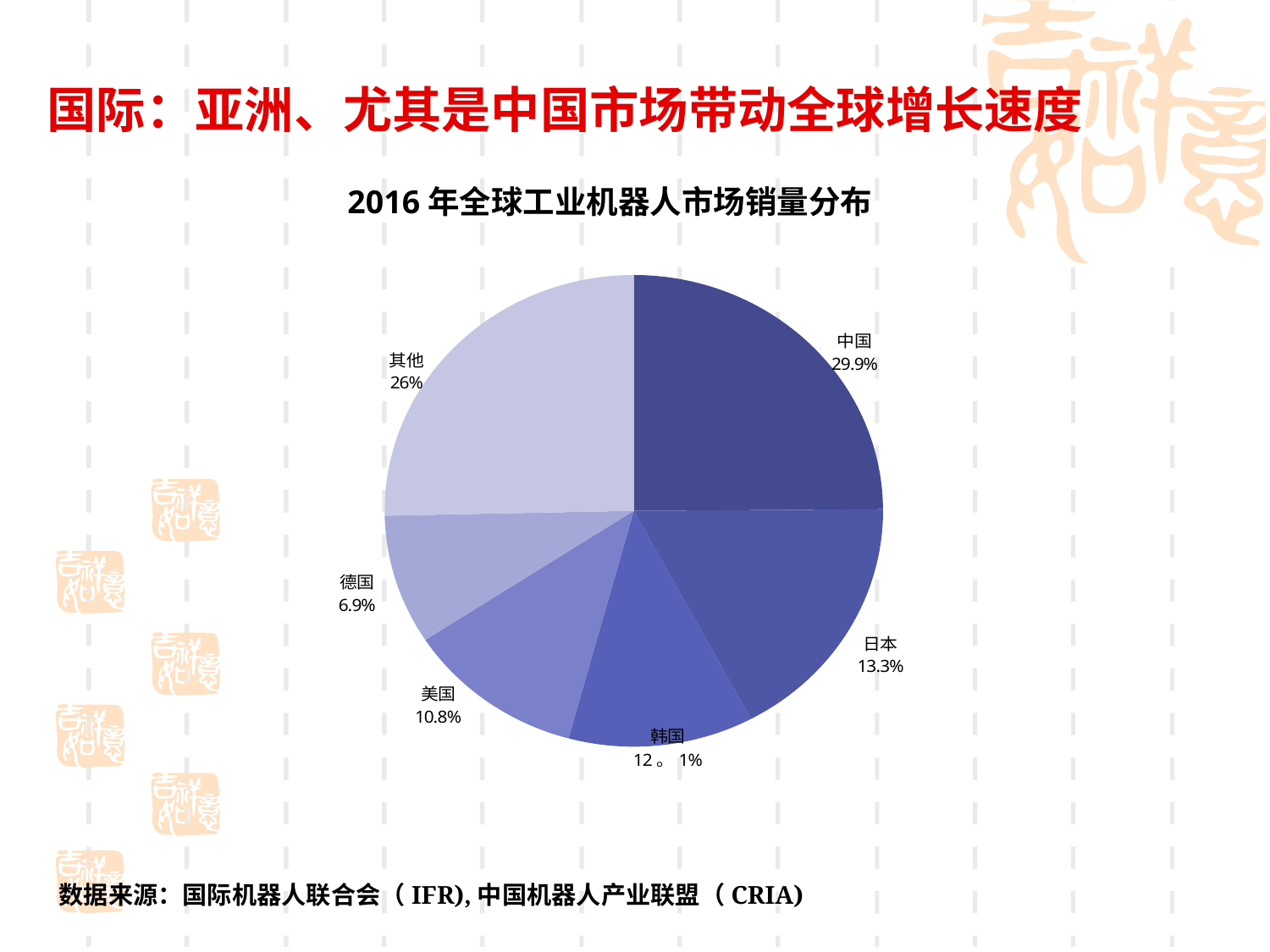
What share of the pie does 中国 hold in the 2016 年全球工业机器人市场销量分布 chart? 29.9% What share of the pie is labelled 其他? 26% What percentage is shown for 德国? 6.9% What type of chart is shown on the slide? Pie chart How many percentage points larger is the 中国 share than the 日本 share? 16.6 percentage points What percentage is shown for 日本? 13.3% What percentage is shown for 美国? 10.8% Which slice of the pie is the largest? 中国 Which has the larger share, 美国 or 德国? 美国 What is the title of the chart? 2016 年全球工业机器人市场销量分布 Which slice of the pie is the smallest? 德国 How many slices does the pie chart have? 6